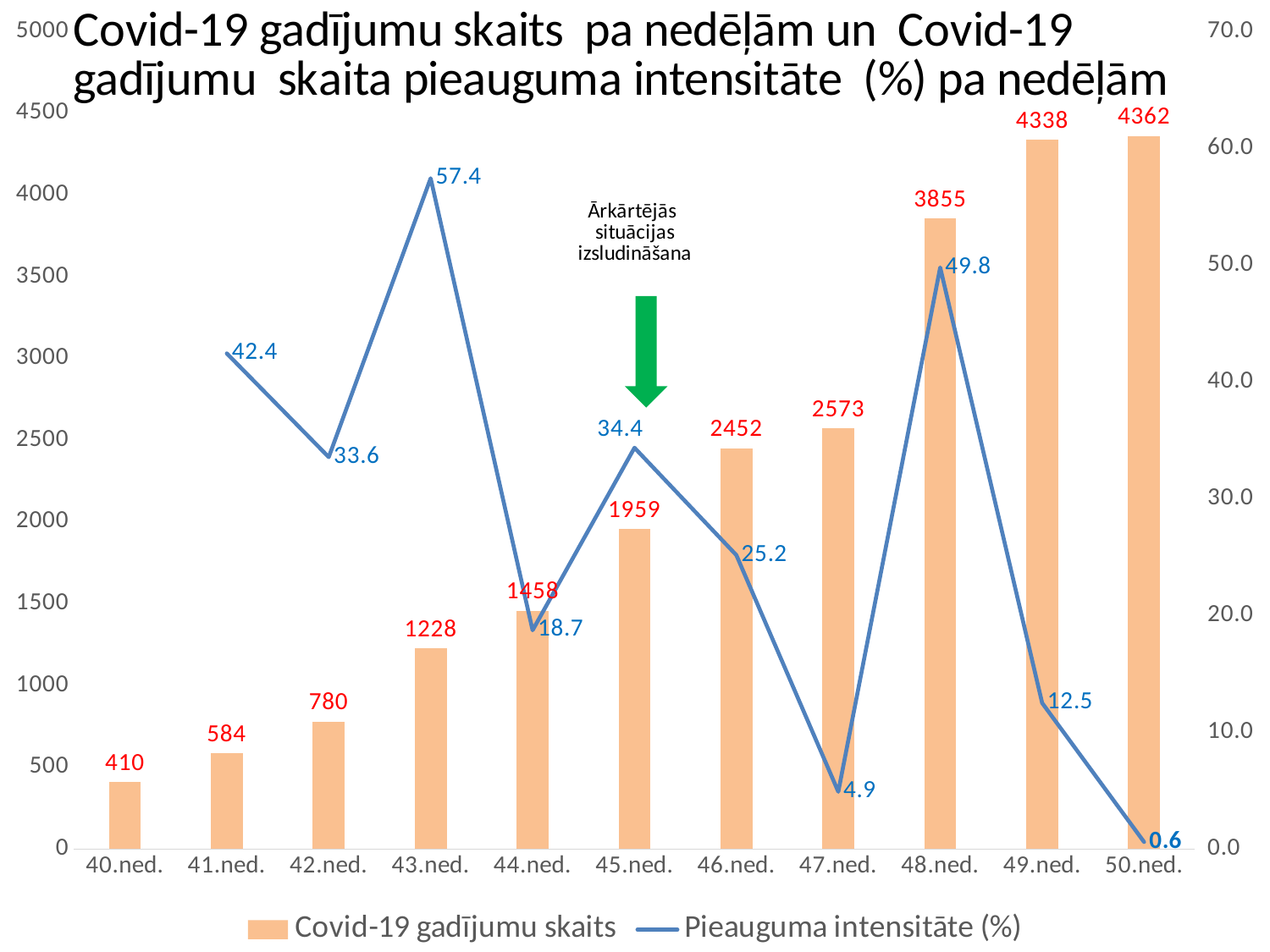
Do the Covid-19 gadījumu skaits values rise or fall from 40.ned. to 50.ned.? Rise What kind of chart is used for the Covid-19 gadījumu skaits series? Bar chart Which week has the lowest Pieauguma intensitāte (%) value? 50.ned. How many series does the legend list? 2 Which week has the highest Covid-19 gadījumu skaits? 50.ned. What is the Covid-19 gadījumu skaits value for 45.ned.? 1959 What is the Pieauguma intensitāte (%) value for 43.ned.? 57.4 How many weeks are shown on the x axis? 11 What is the difference in Covid-19 gadījumu skaits between 48.ned. and 47.ned.? 1282 Which week has the highest Pieauguma intensitāte (%) value? 43.ned. Is the Covid-19 gadījumu skaits for 46.ned. greater or less than 2000? greater Which is larger, the Pieauguma intensitāte (%) for 41.ned. or for 42.ned.? 41.ned.